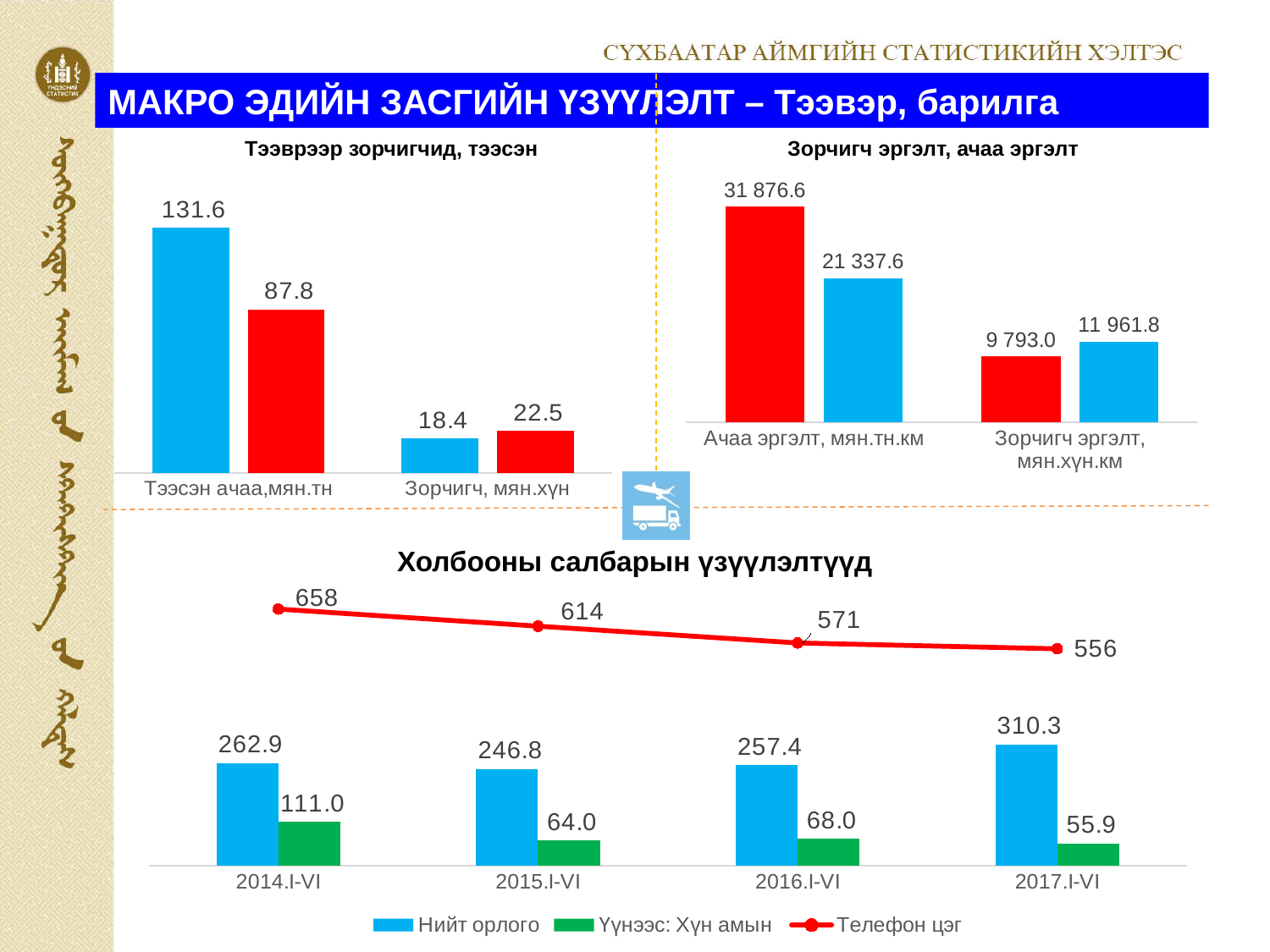
In the 'Холбооны салбарын үзүүлэлтүүд' chart, which period has the lowest value for Үүнээс: Хүн амын? 2017.I-VI In the 'Холбооны салбарын үзүүлэлтүүд' chart, what is the difference between Нийт орлого in 2017.I-VI and 2016.I-VI? 52.9 In the 'Холбооны салбарын үзүүлэлтүүд' chart, what is the value of Телефон цэг for 2014.I-VI? 658 How many periods are shown on the x axis of the 'Холбооны салбарын үзүүлэлтүүд' chart? 4 In the 'Зорчигч эргэлт, ачаа эргэлт' chart, what is the difference between the blue and red bars for Зорчигч эргэлт, мян.хүн.км? 2 168.8 In the 'Тээврээр зорчигчид, тээсэн' chart, what is the value of the blue bar for Тээсэн ачаа,мян.тн? 131.6 In the 'Холбооны салбарын үзүүлэлтүүд' chart, does the Телефон цэг line rise or fall from 2014.I-VI to 2017.I-VI? fall In the 'Холбооны салбарын үзүүлэлтүүд' chart, what is the value of Нийт орлого for 2017.I-VI? 310.3 In the 'Зорчигч эргэлт, ачаа эргэлт' chart, what is the value of the red bar for Ачаа эргэлт, мян.тн.км? 31 876.6 How many series does the legend of the 'Холбооны салбарын үзүүлэлтүүд' chart list? 3 What type of chart is the 'Зорчигч эргэлт, ачаа эргэлт' chart? bar chart In the 'Тээврээр зорчигчид, тээсэн' chart, which is larger for Зорчигч, мян.хүн: the blue bar or the red bar? the red bar